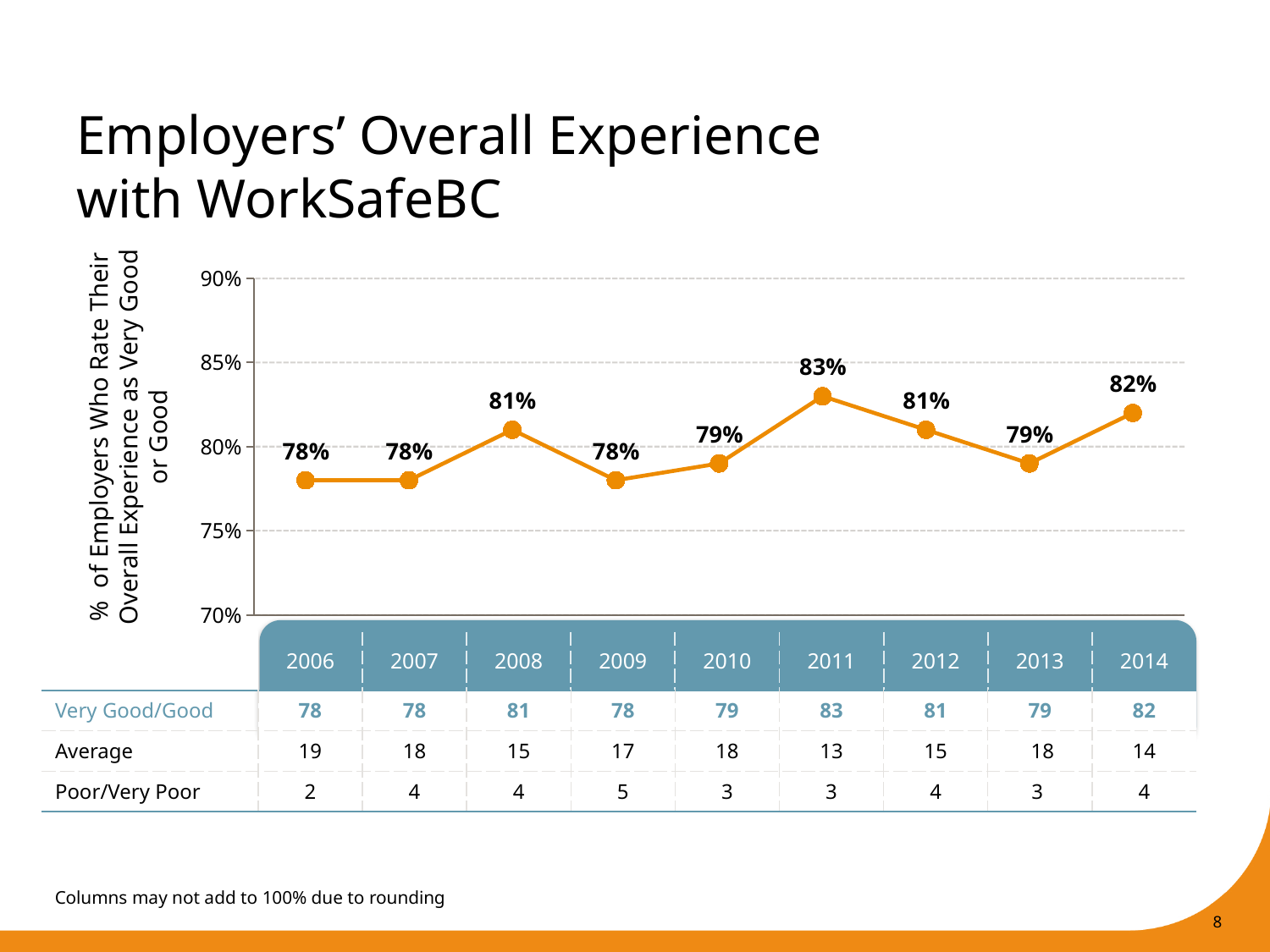
What is the plotted value for 2009? 78% What kind of chart is shown on the slide? Line chart What percentage of employers rated their overall experience as Very Good or Good in 2011? 83% Which year has the highest percentage of employers rating their experience Very Good or Good? 2011 What is the title of the slide containing the chart? Employers' Overall Experience with WorkSafeBC What is the plotted value for 2014? 82% How many years are plotted on the chart? 9 Does the plotted value rise or fall from 2013 to 2014? Rise Is the value for 2011 greater or less than 80%? greater Which is larger, the value for 2008 or the value for 2010? 2008 What is the lowest value shown on the vertical axis? 70% What is the difference between the 2011 value and the 2006 value? 5 percentage points